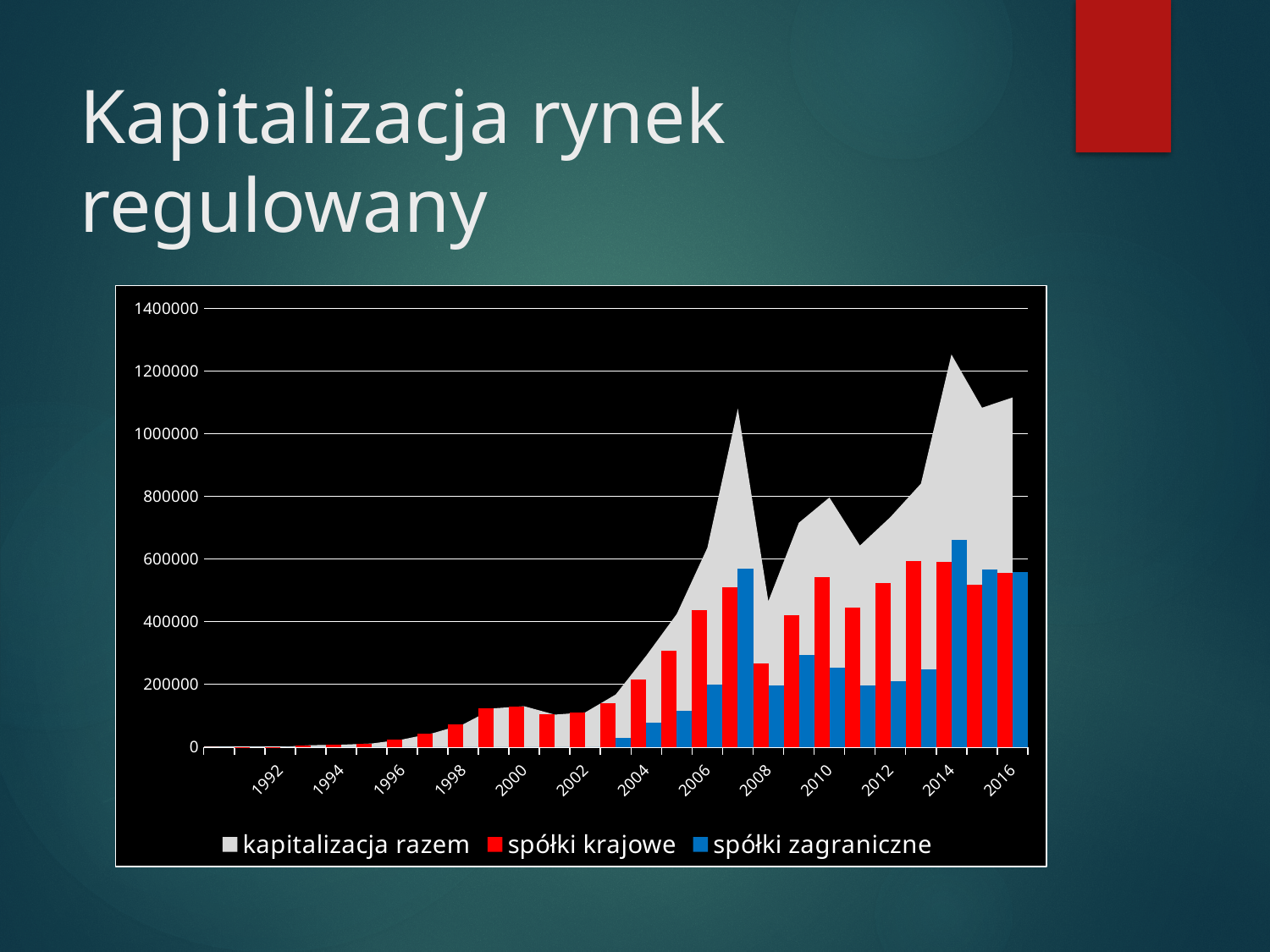
In which year does the kapitalizacja razem series reach its highest value? 2014 Is the value for spółki zagraniczne in 2014 greater or less than 600000? greater What kind of chart is this? A combined area and bar chart Which series is shown in red? spółki krajowe Is the value for spółki zagraniczne in 2008 greater or less than 400000? less In which year is the spółki zagraniczne bar the tallest? 2014 Which series is drawn as the grey area? kapitalizacja razem How many series does the legend list? 3 Does the kapitalizacja razem series rise or fall from 2008 to 2010? rise Is the value for spółki krajowe in 2007 greater or less than 400000? greater In 2010, which is larger: spółki krajowe or spółki zagraniczne? spółki krajowe